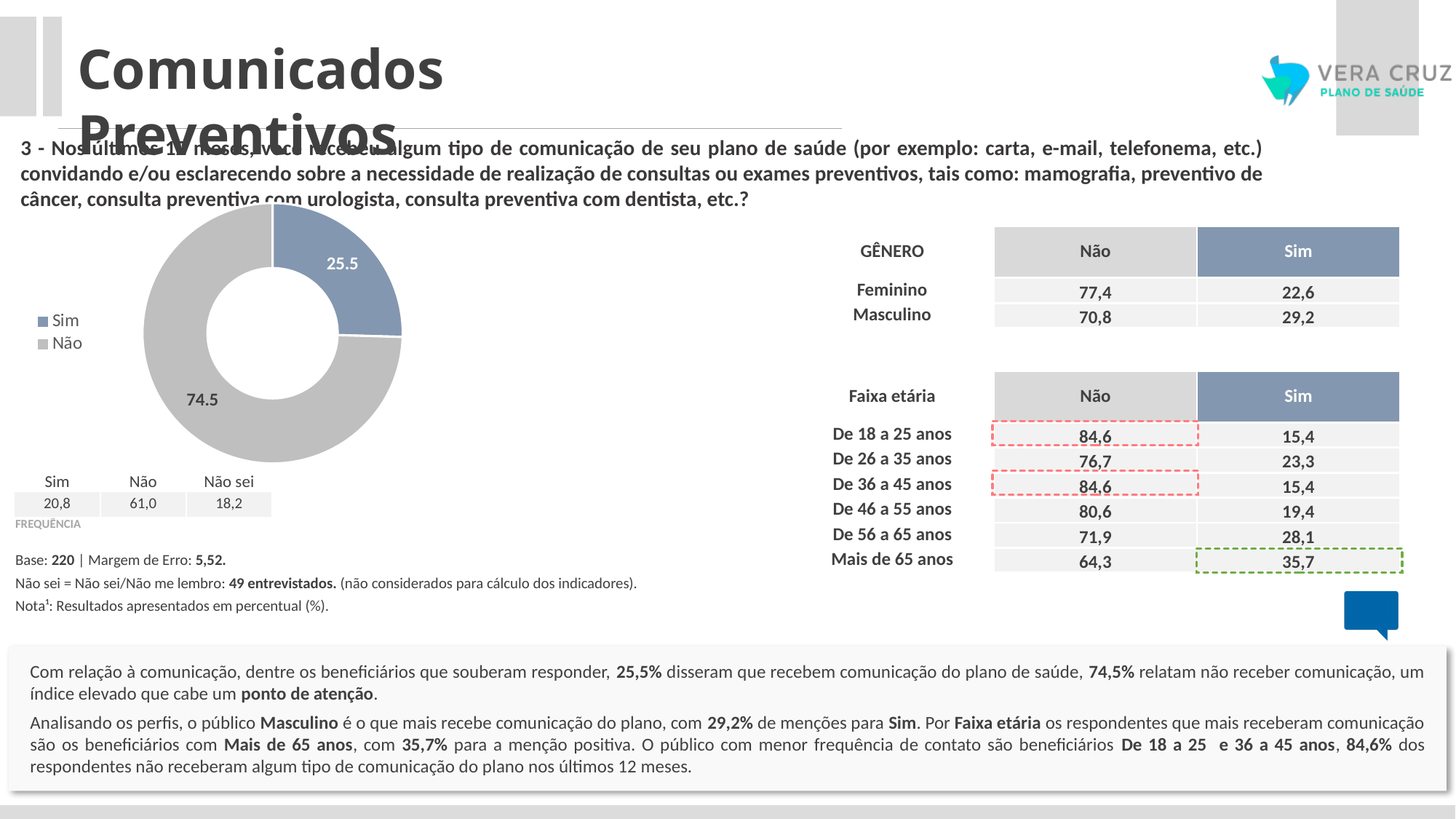
What are the two legend entries of the donut chart? Sim, Não What value is shown for the "Sim" slice of the donut chart? 25.5 What is the difference between the "Não" and "Sim" values in the donut chart? 49 Which slice of the donut chart is the largest? Não How many entries does the legend of the donut chart list? 2 What share of the donut chart does the "Não" slice represent? 74.5 What value is shown for the "Não" slice of the donut chart? 74.5 Which colour represents "Não" in the donut chart? Grey What kind of chart is shown on the left of the slide? Donut (pie) chart In the donut chart, which is larger: "Sim" or "Não"? Não Which slice of the donut chart is the smallest? Sim How many slices does the donut chart have? 2